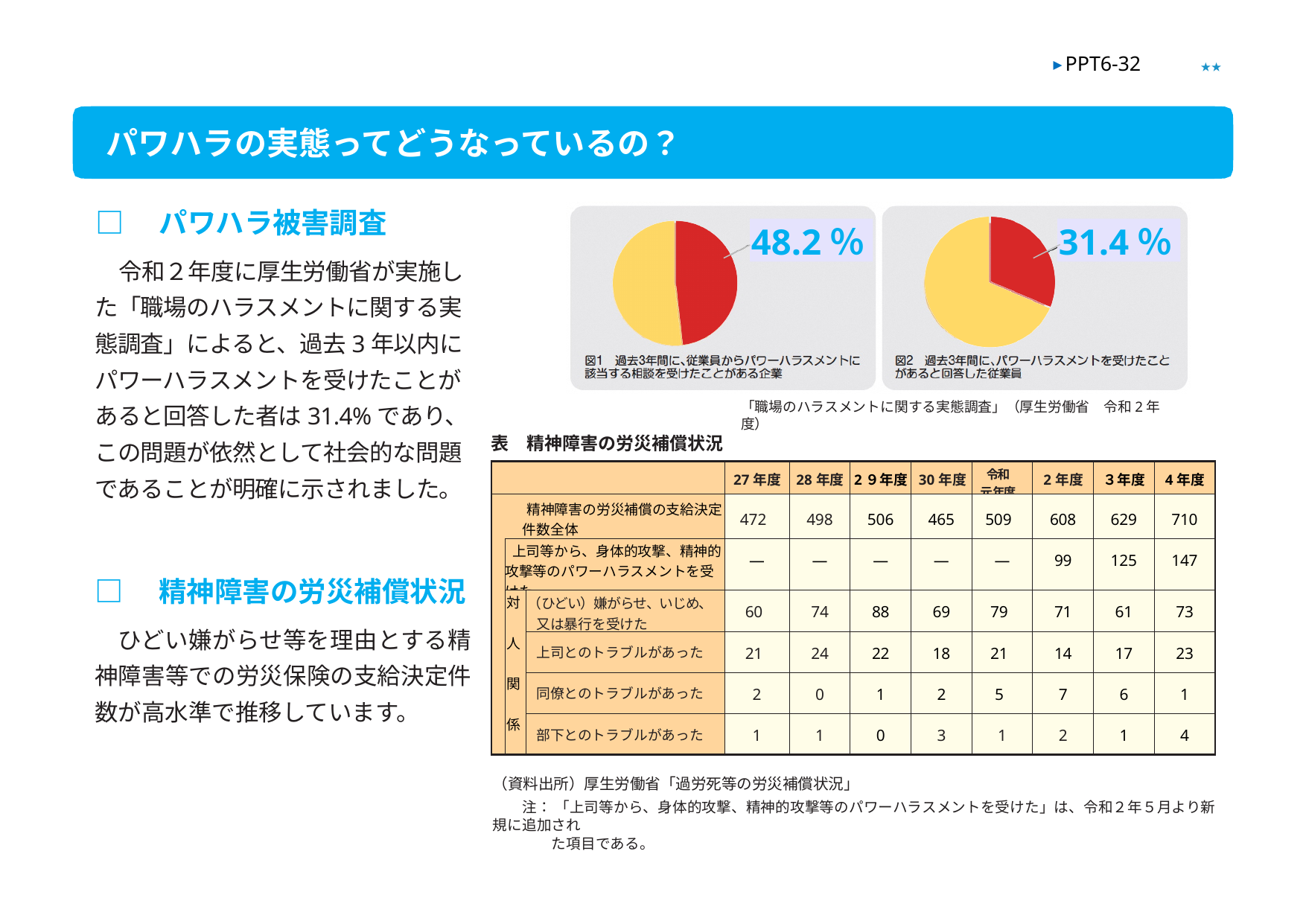
Which pie chart has the larger red slice, 図1 (left) or 図2 (right)? 図1 (left) In 図2 (the right pie chart), what percentage is shown for the red slice? 31.4 % What colour is the slice that carries the percentage label in both pie charts? Red What kind of chart is 図2 (the right chart)? Pie chart How many slices does the pie chart in 図1 (left) have? 2 How many pie charts are shown on the slide? 2 In 図1 (the left pie chart), what share of the pie does the yellow slice represent? 51.8 % In 図1 (the left pie chart), what percentage is shown for the red slice? 48.2 % What is the difference between the labelled value in 図1 (48.2 %) and the labelled value in 図2 (31.4 %)? 16.8 percentage points What kind of chart is 図1 (the left chart)? Pie chart How many slices does the pie chart in 図2 (right) have? 2 In 図2 (the right pie chart), is the red slice more or less than half of the pie? Less